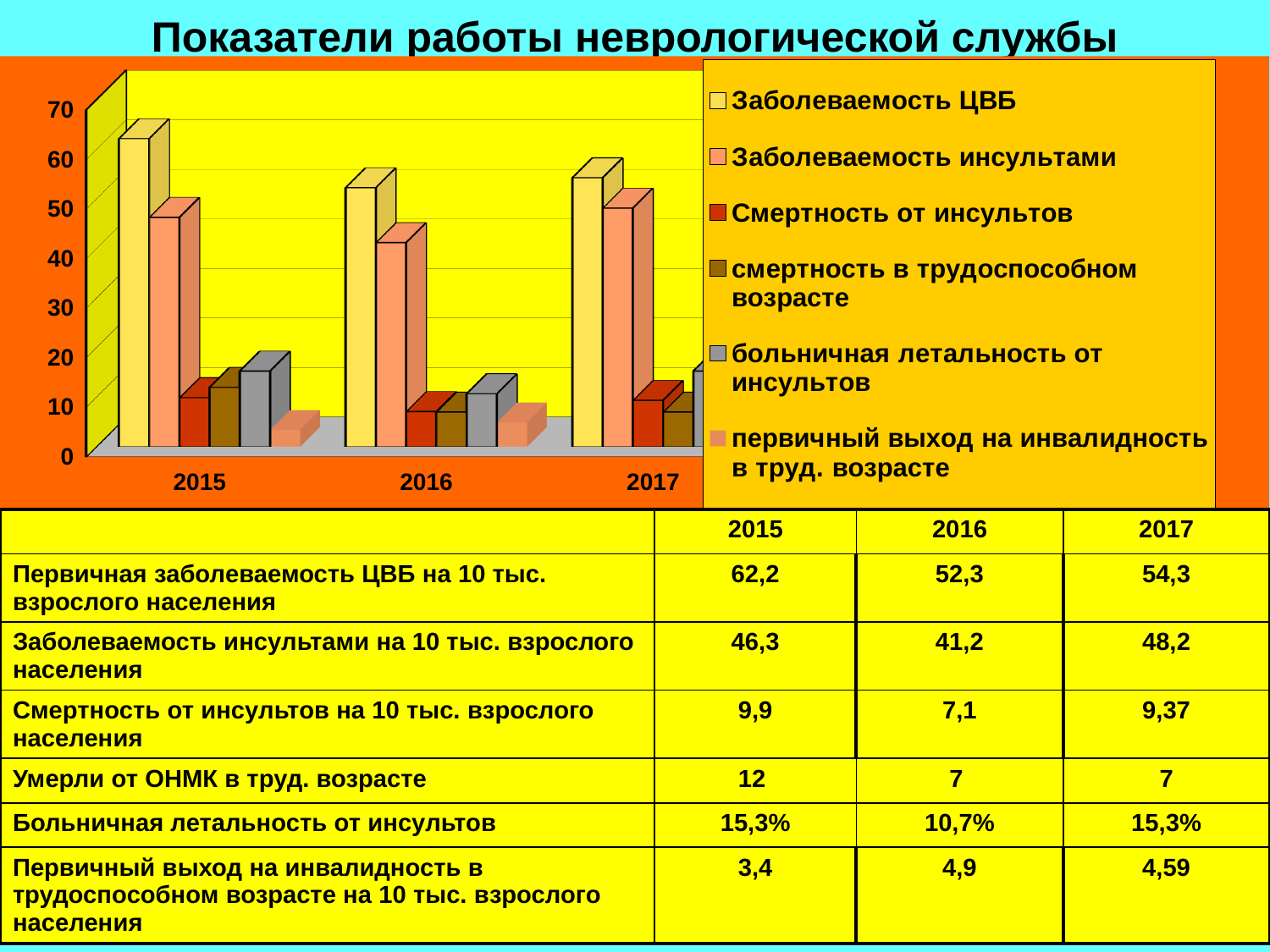
What kind of chart is shown on the slide? Bar chart How many series does the chart legend list? 6 In 2017, which is larger: Заболеваемость ЦВБ or Заболеваемость инсультами? Заболеваемость ЦВБ In which year is the value for Заболеваемость ЦВБ highest? 2015 What is the title of the slide containing the chart? Показатели работы неврологической службы Is the value for Заболеваемость инсультами in 2016 greater or less than 50? less Is the value for Заболеваемость ЦВБ in 2015 greater or less than 50? greater In which year is the value for Заболеваемость инсультами lowest? 2016 Is the value for Смертность от инсультов in 2015 greater or less than 20? less Does the value for Заболеваемость ЦВБ rise or fall from 2015 to 2016? fall How many years are shown on the x axis of the chart? 3 Which year has the larger value for Заболеваемость инсультами, 2016 or 2017? 2017